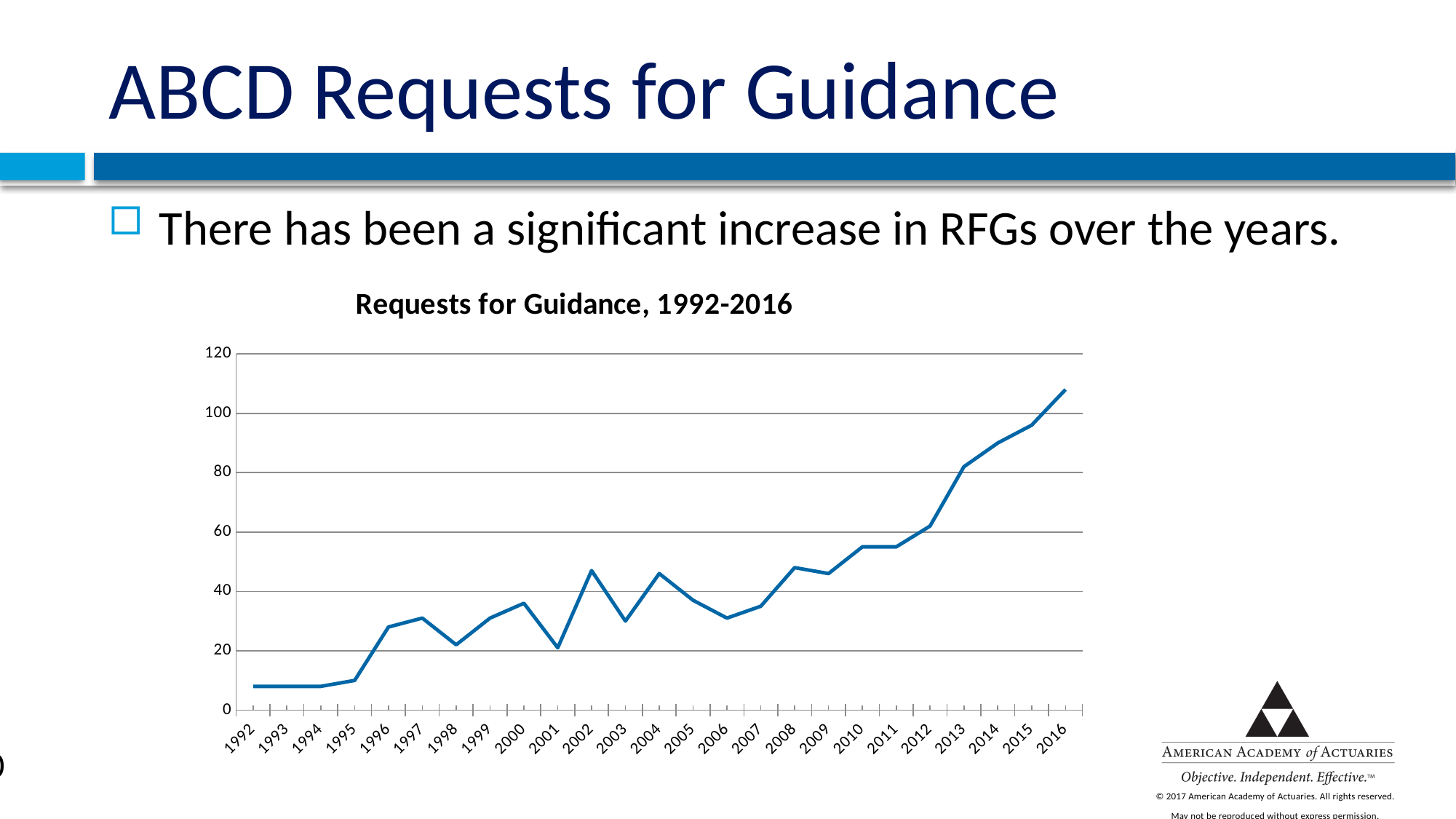
Is the value for 2001 greater or less than 40? less Is the value for 1995 greater or less than 20? less What kind of chart is shown on the slide? line chart Overall, do the values rise or fall from 1992 to 2016? rise Which year has the larger value, 2004 or 2006? 2004 Is the value for 2016 greater or less than 100? greater What is the title of the chart? Requests for Guidance, 1992-2016 How many years are plotted on the x axis of the chart? 25 Which year has the larger value, 2002 or 2003? 2002 Which year has the highest number of requests for guidance? 2016